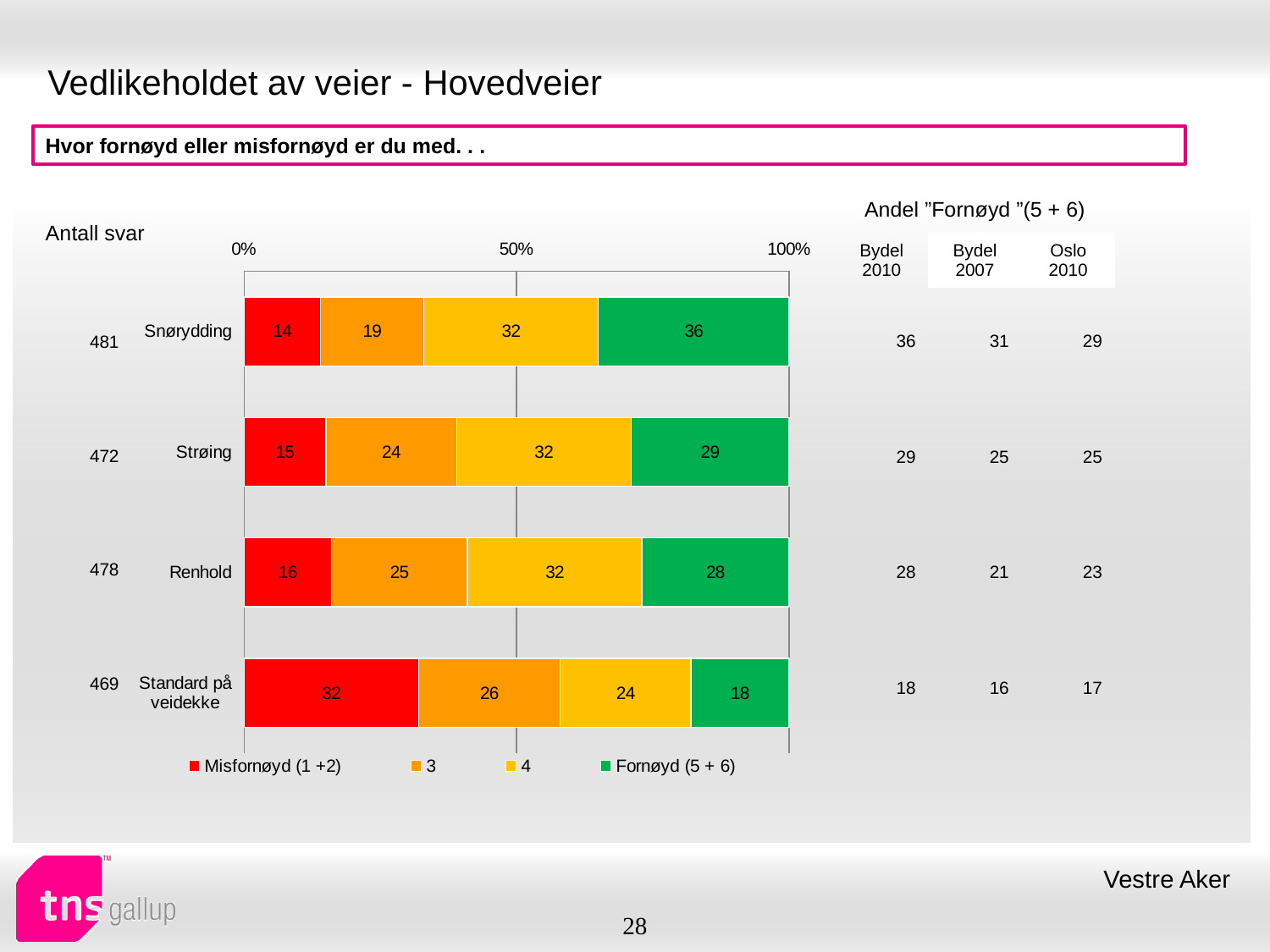
What is the value of series 4 for Renhold? 32 What is the value of series 3 for Strøing? 24 Which category has the lowest Misfornøyd (1 +2) value? Snørydding How many series does the legend list? 4 What is the Misfornøyd (1 +2) value for Standard på veidekke? 32 What kind of chart is shown on the slide? stacked bar chart What colour represents the Fornøyd (5 + 6) series in the chart? green What is the difference between the Fornøyd (5 + 6) values for Snørydding and Standard på veidekke? 18 What is the Fornøyd (5 + 6) value for Snørydding? 36 Which category has the highest Fornøyd (5 + 6) value? Snørydding Which is larger, the Misfornøyd (1 +2) value for Renhold or for Strøing? Renhold How many categories are plotted in the chart? 4